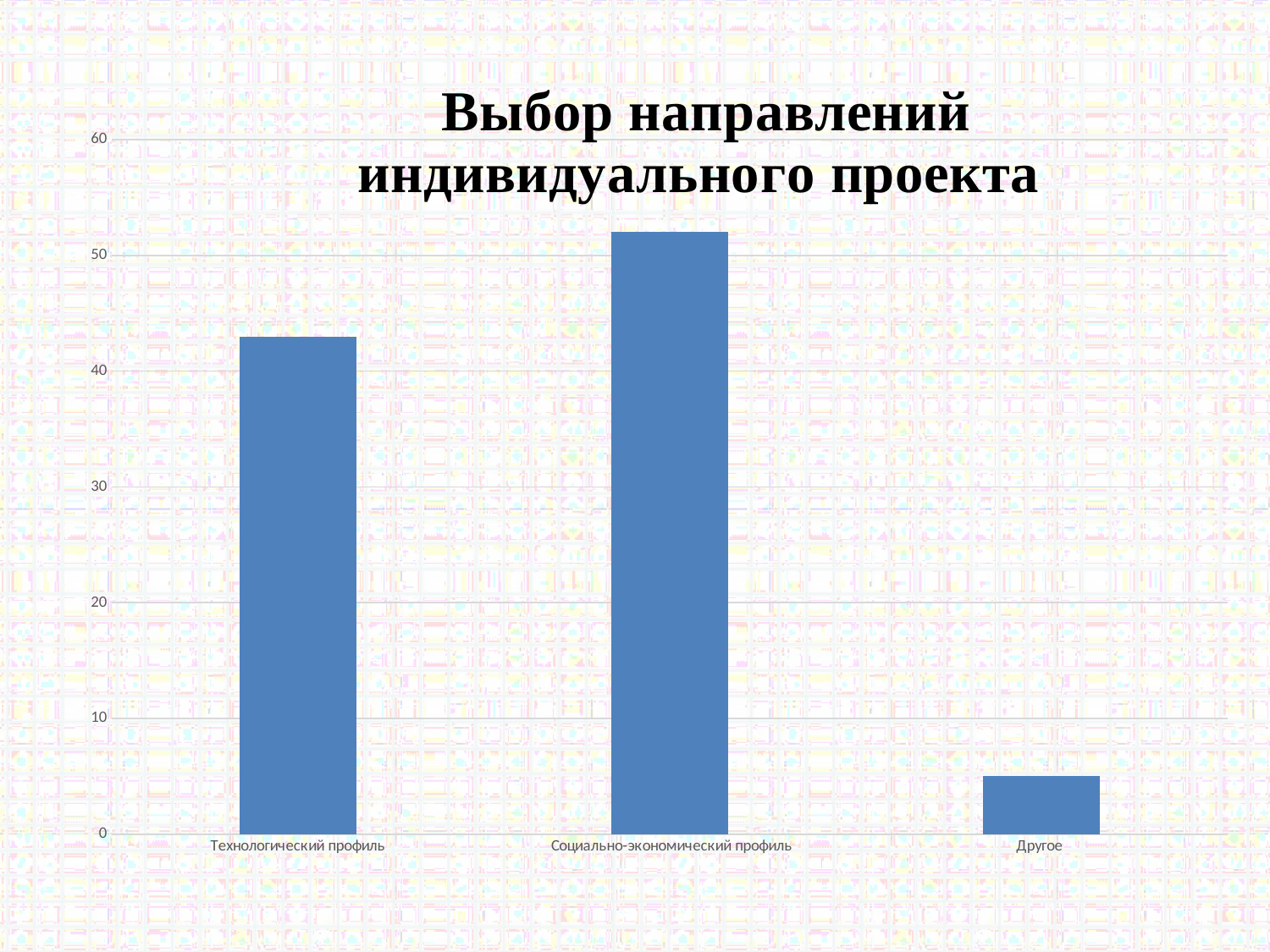
What is the title of the chart? Выбор направлений индивидуального проекта Is the value for Технологический профиль greater or less than 40? greater Which category has the lowest value? Другое Which category has the highest value? Социально-экономический профиль How many categories are shown on the x axis of the chart? 3 What is the highest value shown on the vertical axis? 60 Which is larger, the value for Технологический профиль or the value for Социально-экономический профиль? Социально-экономический профиль Which is larger, the value for Технологический профиль or the value for Другое? Технологический профиль Is the value for Социально-экономический профиль greater or less than 50? greater Is the value for Технологический профиль greater or less than 50? less What kind of chart is shown on the slide? bar chart